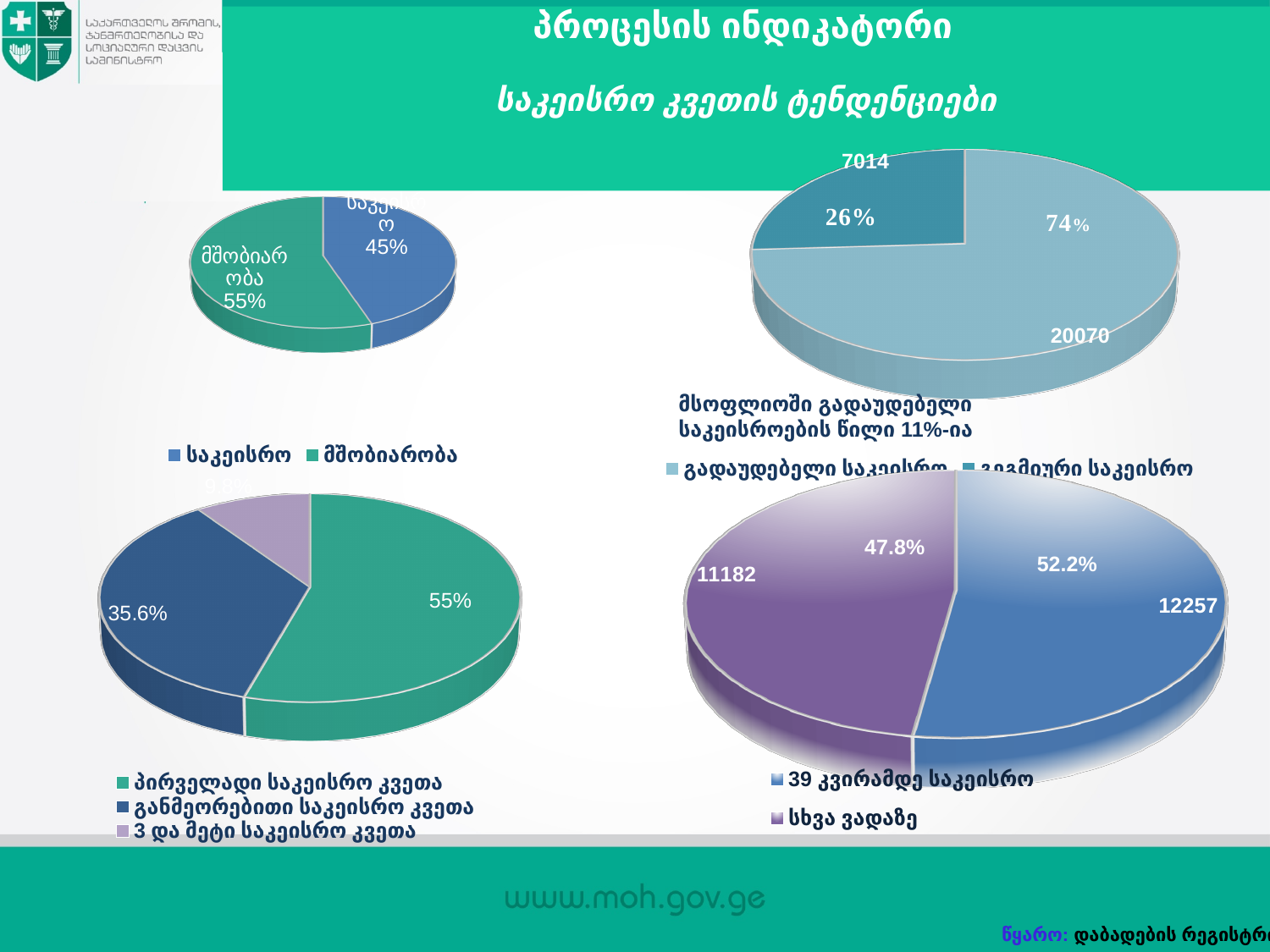
In the top-right pie chart, what value is printed on the slice labelled 74%? 20070 In the top-right pie chart, what value is printed on the slice labelled 26%? 7014 In the bottom-right pie chart, what value is printed for 39 კვირამდე საკეისრო? 12257 In the bottom-right pie chart, what percentage is shown for სხვა ვადაზე? 47.8% In the bottom-left pie chart, which category has the smallest share? 3 და მეტი საკეისრო კვეთა In the top-left pie chart, what share is labelled for მშობიარობა? 55% In the top-left pie chart, what share is labelled for საკეისრო? 45% What type of chart is the bottom-right chart? Pie chart In the bottom-left pie chart, what share is shown for განმეორებითი საკეისრო კვეთა? 35.6% In the top-right pie chart, what is the difference between the two slice values, 20070 and 7014? 13056 How many slices does the bottom-left pie chart have? 3 In the top-left pie chart, which slice is larger, საკეისრო or მშობიარობა? მშობიარობა